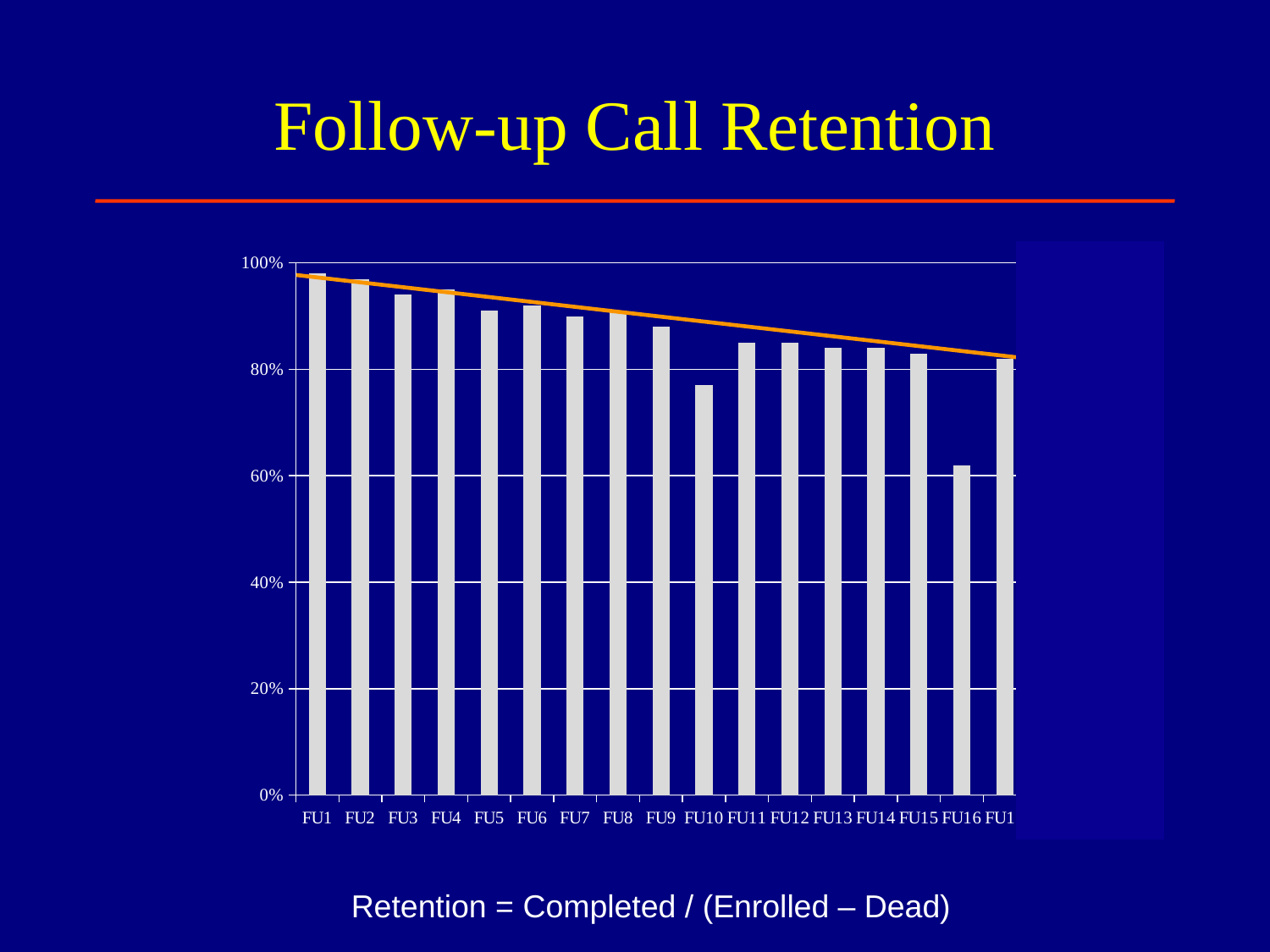
Which has the higher retention, FU1 or FU16? FU1 Which follow-up call has the lowest retention in the chart? FU16 Which has the higher retention, FU9 or FU10? FU9 Which has the higher retention, FU10 or FU16? FU10 Do the retention values generally rise or fall from FU1 to FU16? fall What formula for retention is given below the chart? Retention = Completed / (Enrolled – Dead) Is the retention value for FU10 greater or less than 80%? less What is the title of the slide containing the chart? Follow-up Call Retention Is the retention value for FU16 greater or less than 80%? less What kind of chart is shown on the slide? bar chart Is the retention value for FU1 greater or less than 80%? greater